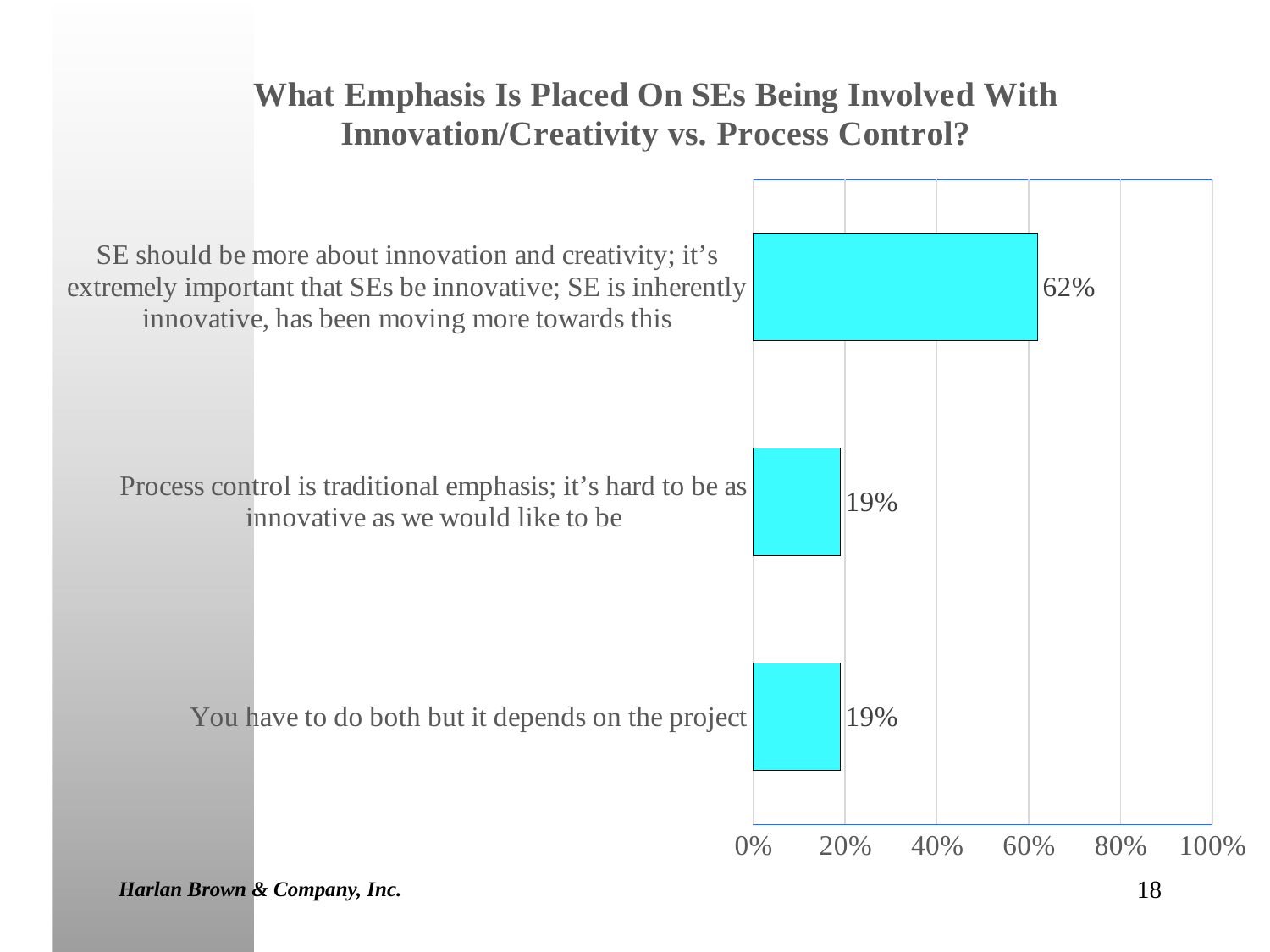
Is the value for 'SE should be more about innovation and creativity' greater or less than 40%? greater How many response categories are shown in the chart? 3 What percentage is shown for the response 'Process control is traditional emphasis; it's hard to be as innovative as we would like to be'? 19% What kind of chart is shown on the slide? Bar chart What percentage is shown for the response 'You have to do both but it depends on the project'? 19% What percentage is shown for the response 'SE should be more about innovation and creativity; it's extremely important that SEs be innovative; SE is inherently innovative, has been moving more towards this'? 62% What is the title of the chart? What Emphasis Is Placed On SEs Being Involved With Innovation/Creativity vs. Process Control? What is the difference in percentage points between the 'SE should be more about innovation and creativity' response and the 'Process control is traditional emphasis' response? 43 percentage points Which is larger: the value for 'SE should be more about innovation and creativity' or the value for 'You have to do both but it depends on the project'? SE should be more about innovation and creativity What is the maximum value shown on the horizontal axis? 100% Which response has the highest percentage? SE should be more about innovation and creativity; it's extremely important that SEs be innovative; SE is inherently innovative, has been moving more towards this Is the value for 'You have to do both but it depends on the project' greater or less than 20%? less